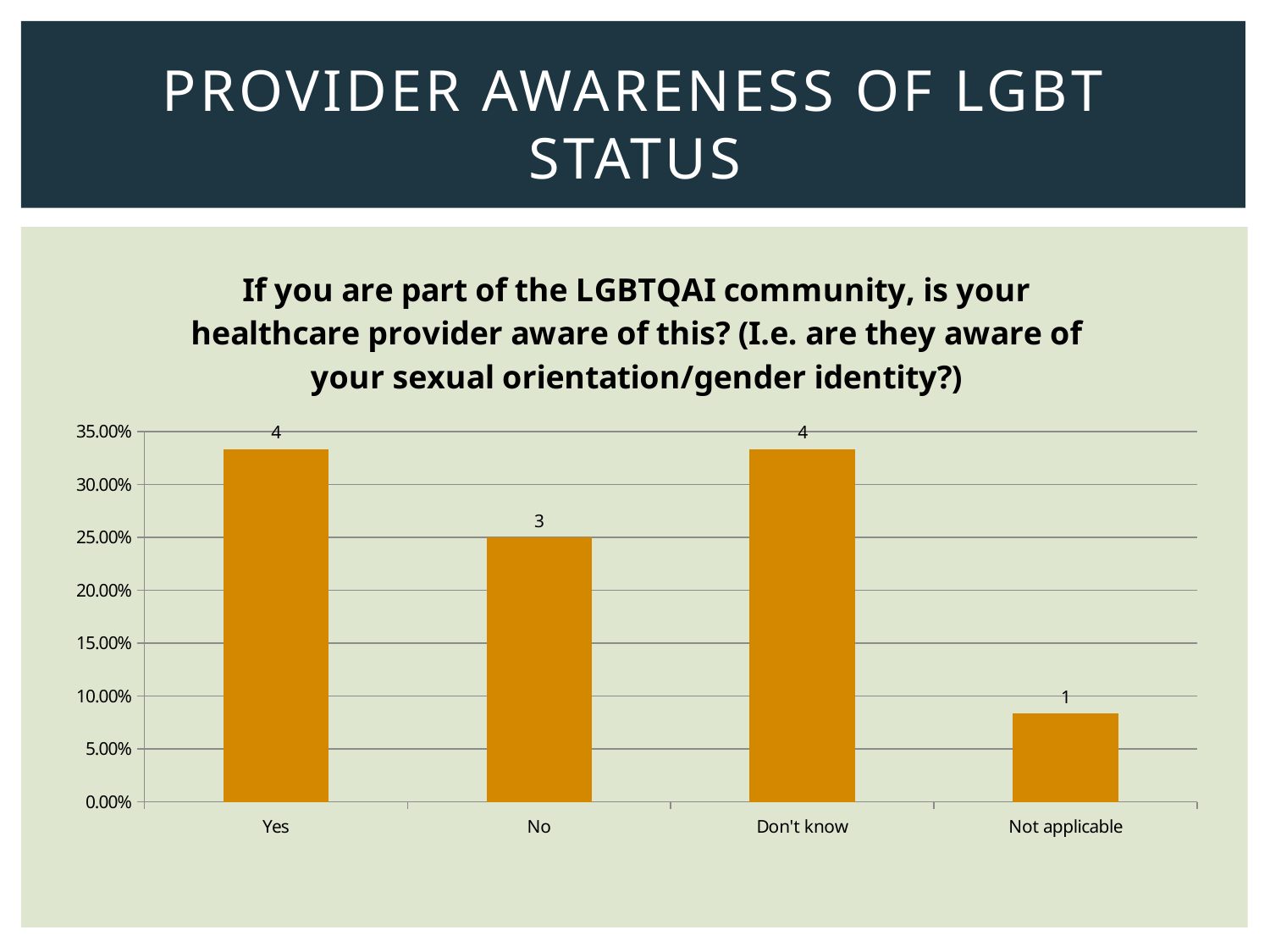
What is the difference between the data labels for "Yes" and "No"? 1 Which category has the lowest bar? Not applicable What kind of chart is shown on the slide? Bar chart How many categories are shown on the x axis? 4 What data label is shown on the bar for "Not applicable"? 1 What data label is shown on the bar for "No"? 3 What data label is shown on the bar for "Yes"? 4 Which is larger, the bar for "Yes" or the bar for "No"? Yes Is the value for "Yes" greater or less than 30.00%? greater Is the value for "Not applicable" greater or less than 10.00%? less What is the label of the highest tick on the y axis? 35.00% What data label is shown on the bar for "Don't know"? 4